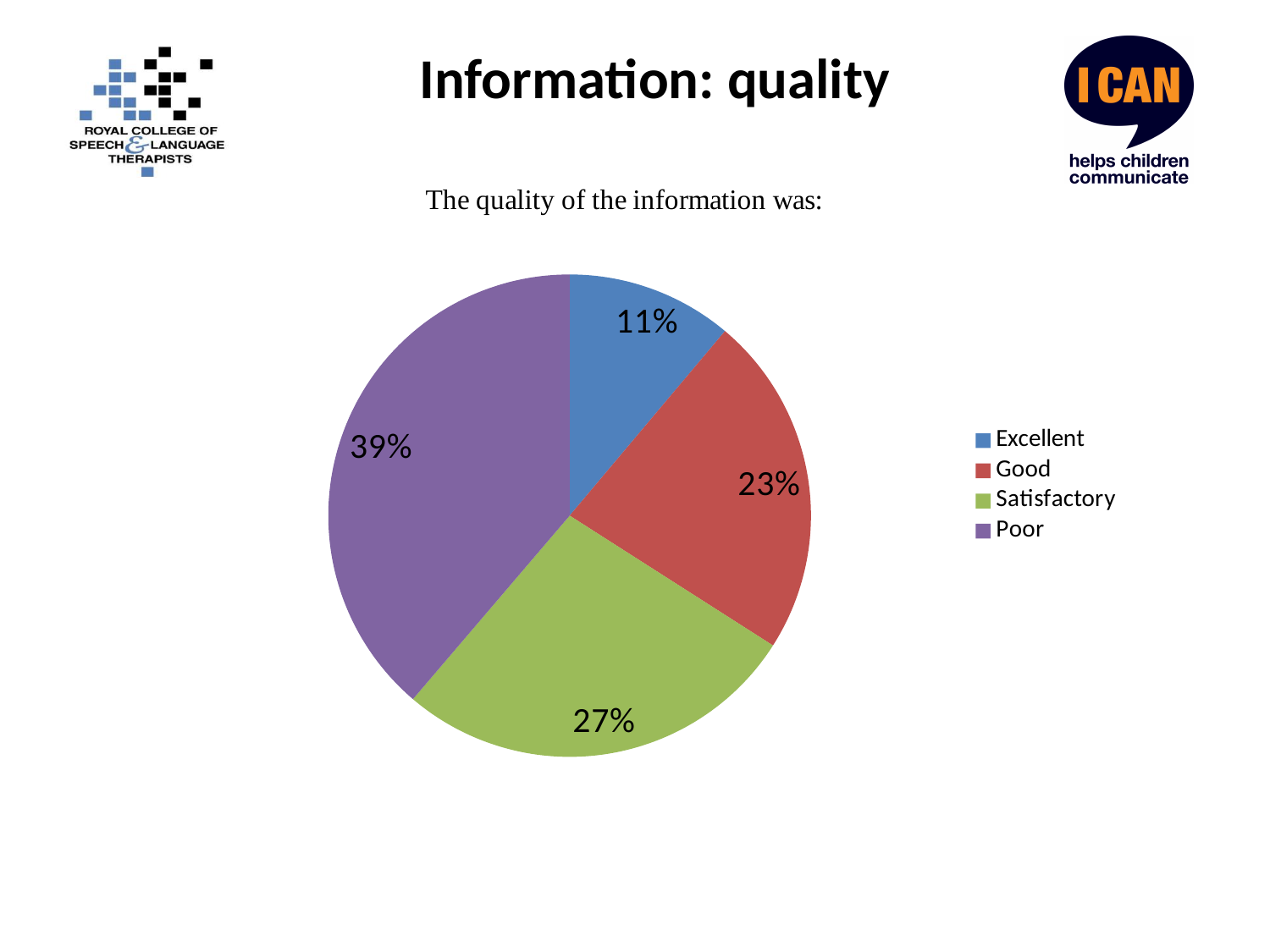
What share of the pie is labelled Excellent? 11% Which category has the smallest slice of the pie? Excellent What share of the pie is labelled Good? 23% Which category has the largest slice of the pie? Poor What is the title of the slide containing the chart? Information: quality What share of the pie is labelled Satisfactory? 27% What kind of chart is shown on the slide? pie chart How many categories does the legend list? 4 Which slice is larger, Good or Satisfactory? Satisfactory What colour is the Poor slice? purple What is the difference in percentage points between the Poor and Excellent slices? 28